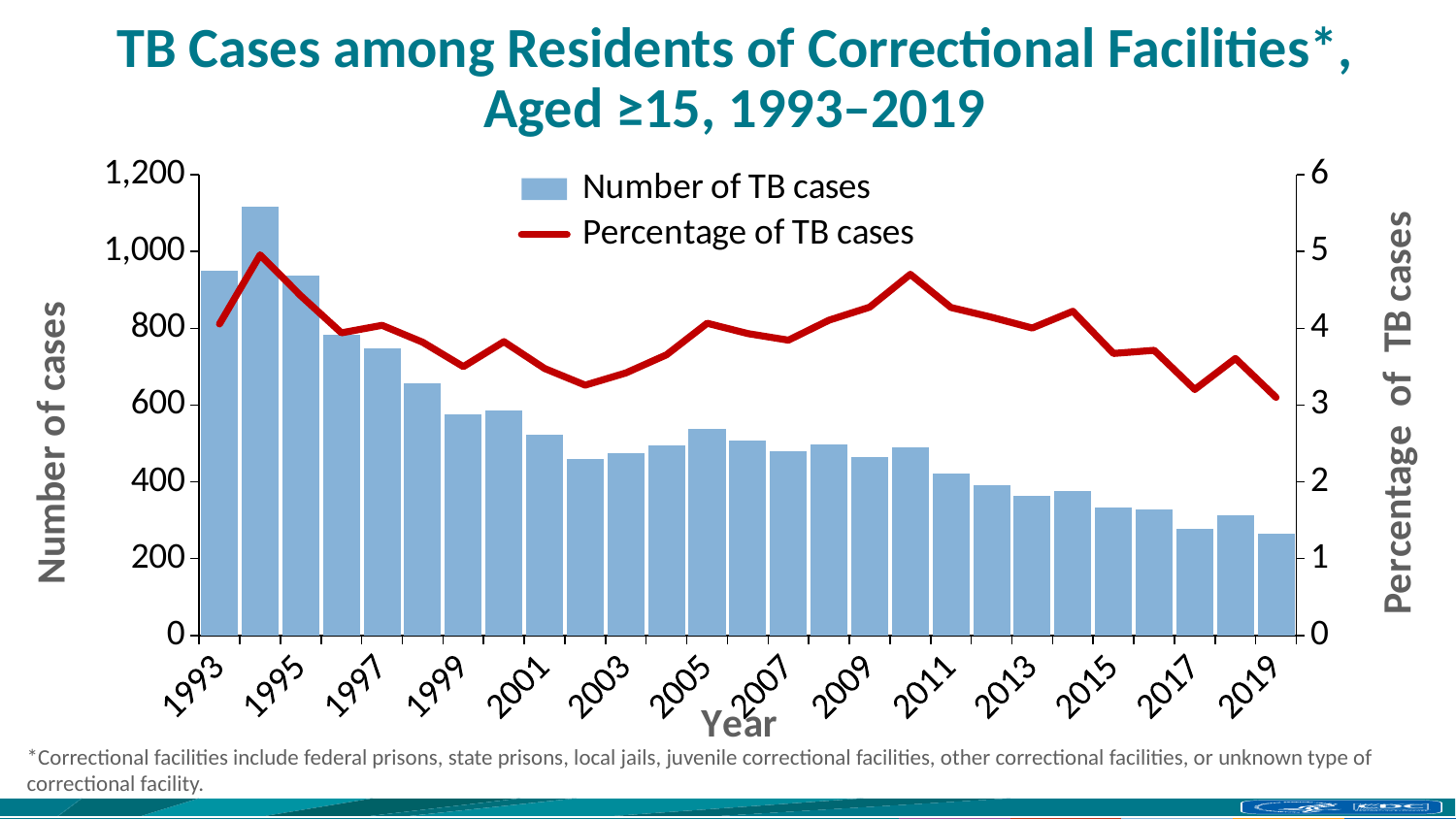
What kind of chart is shown on the slide? A combination bar and line chart Is the percentage of TB cases in 2010 greater or less than 4? greater Is the number of TB cases in 2019 greater or less than 400? less Overall, does the number of TB cases rise or fall from 1993 to 2019? fall Is the percentage of TB cases in 2017 greater or less than 4? less How many years are plotted along the x axis? 27 How many series does the legend list? 2 Which year has the lowest number of TB cases? 2019 Which year has the highest number of TB cases? 1994 Which year has more TB cases, 2005 or 2011? 2005 Which year has the highest percentage of TB cases? 1994